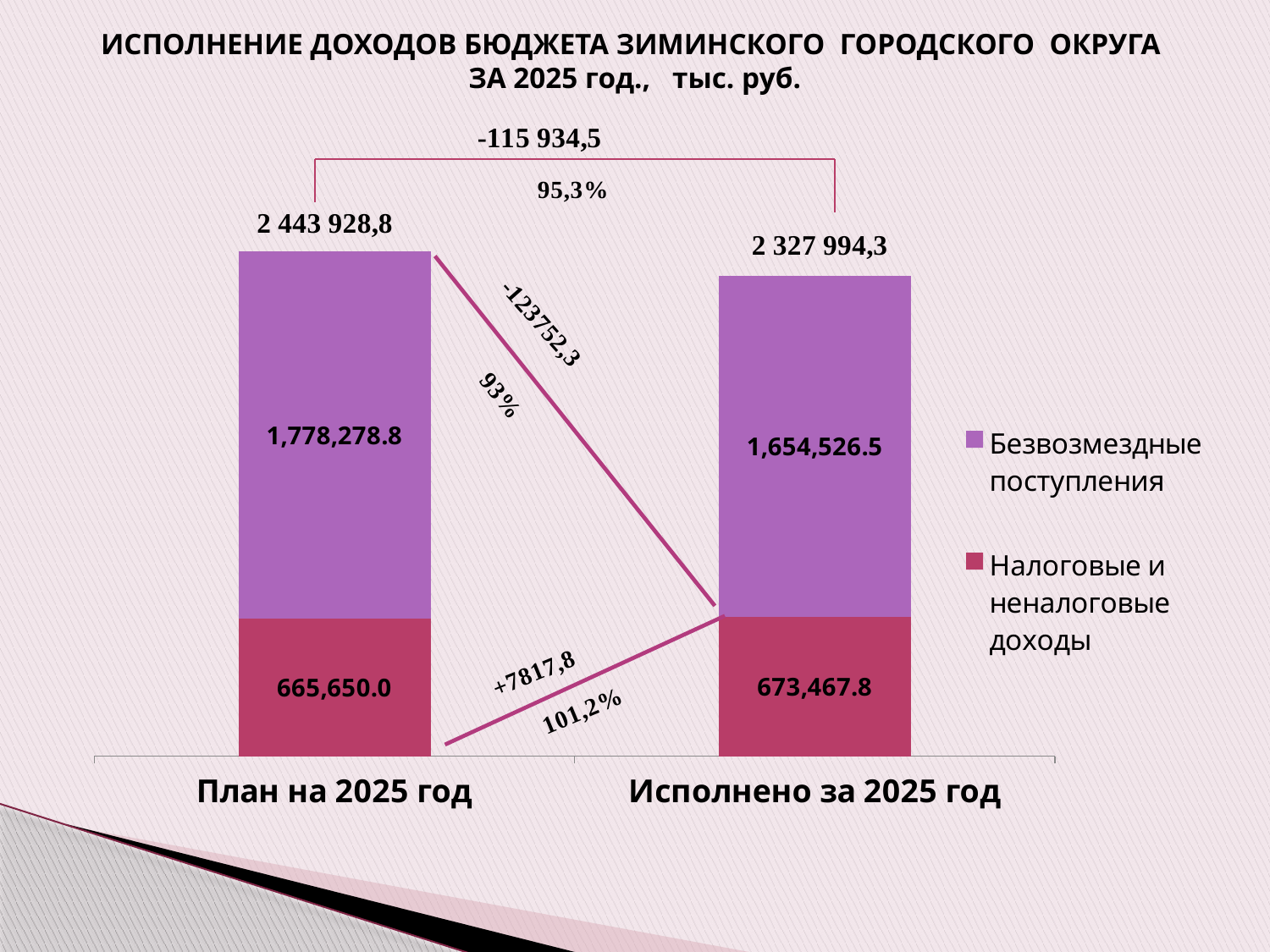
What is the value of Безвозмездные поступления for План на 2025 год? 1,778,278.8 What is the difference between the Безвозмездные поступления values for План на 2025 год and Исполнено за 2025 год? 123,752.3 What type of chart is shown on the slide? stacked bar chart Which category has the higher value for Безвозмездные поступления, План на 2025 год or Исполнено за 2025 год? План на 2025 год What is the value of Налоговые и неналоговые доходы for План на 2025 год? 665,650.0 What is the total of the stacked bar for Исполнено за 2025 год? 2 327 994,3 What is the total of the stacked bar for План на 2025 год? 2 443 928,8 How many categories are shown on the x axis? 2 How many series does the legend list? 2 What is the value of Безвозмездные поступления for Исполнено за 2025 год? 1,654,526.5 What is the value of Налоговые и неналоговые доходы for Исполнено за 2025 год? 673,467.8 Which series is shown in purple in the legend? Безвозмездные поступления